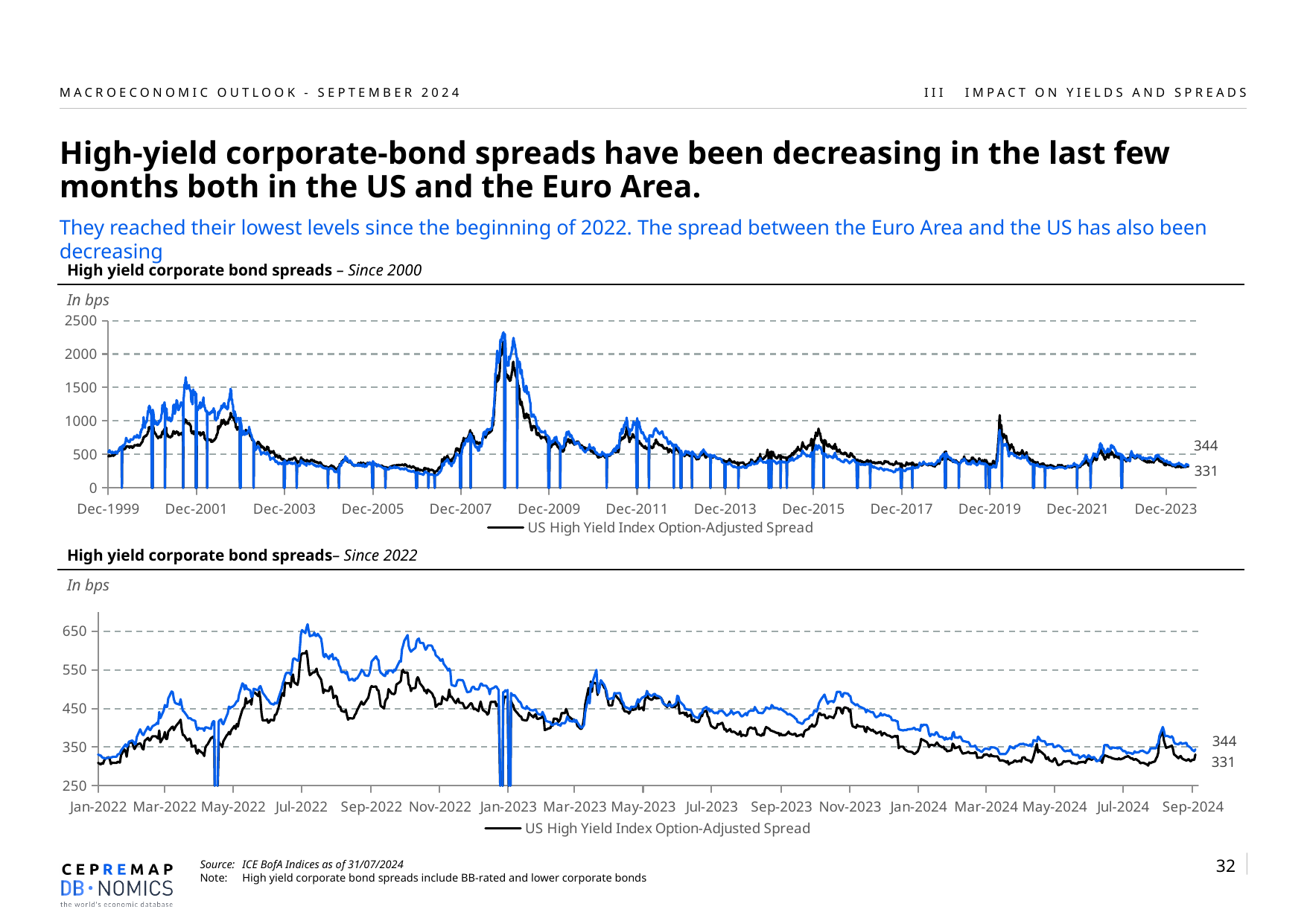
In the 'High yield corporate bond spreads – Since 2022' chart, is the US High Yield Index Option-Adjusted Spread line above or below the other line at the right end of the chart? below What unit is stated for the values in the 'High yield corporate bond spreads – Since 2022' chart? In bps In the 'High yield corporate bond spreads – Since 2000' chart, is the peak of the US High Yield Index Option-Adjusted Spread line between Dec-2007 and Dec-2009 greater or less than 1500? greater In the 'High yield corporate bond spreads – Since 2000' chart, what are the two values labelled at the right end of the lines? 344 and 331 What kind of chart is the 'High yield corporate bond spreads – Since 2000' chart? line chart How many series does the legend of the 'High yield corporate bond spreads – Since 2022' chart list? 1 In the 'High yield corporate bond spreads – Since 2022' chart, what value is labelled at the right end of the US High Yield Index Option-Adjusted Spread line? 331 In the 'High yield corporate bond spreads – Since 2022' chart, does the US High Yield Index Option-Adjusted Spread line rise or fall between Nov-2023 and Sep-2024? fall In the 'High yield corporate bond spreads – Since 2022' chart, is the value of the US High Yield Index Option-Adjusted Spread at Jan-2022 greater or less than 350? less In the 'High yield corporate bond spreads – Since 2000' chart, does the US line reach its highest value around 2008-2009 or around 2020? around 2008-2009 How many x-axis labels are shown on the 'High yield corporate bond spreads – Since 2000' chart? 13 In the 'High yield corporate bond spreads – Since 2022' chart, what is the difference between the two values labelled at the right end of the lines, 344 and 331? 13